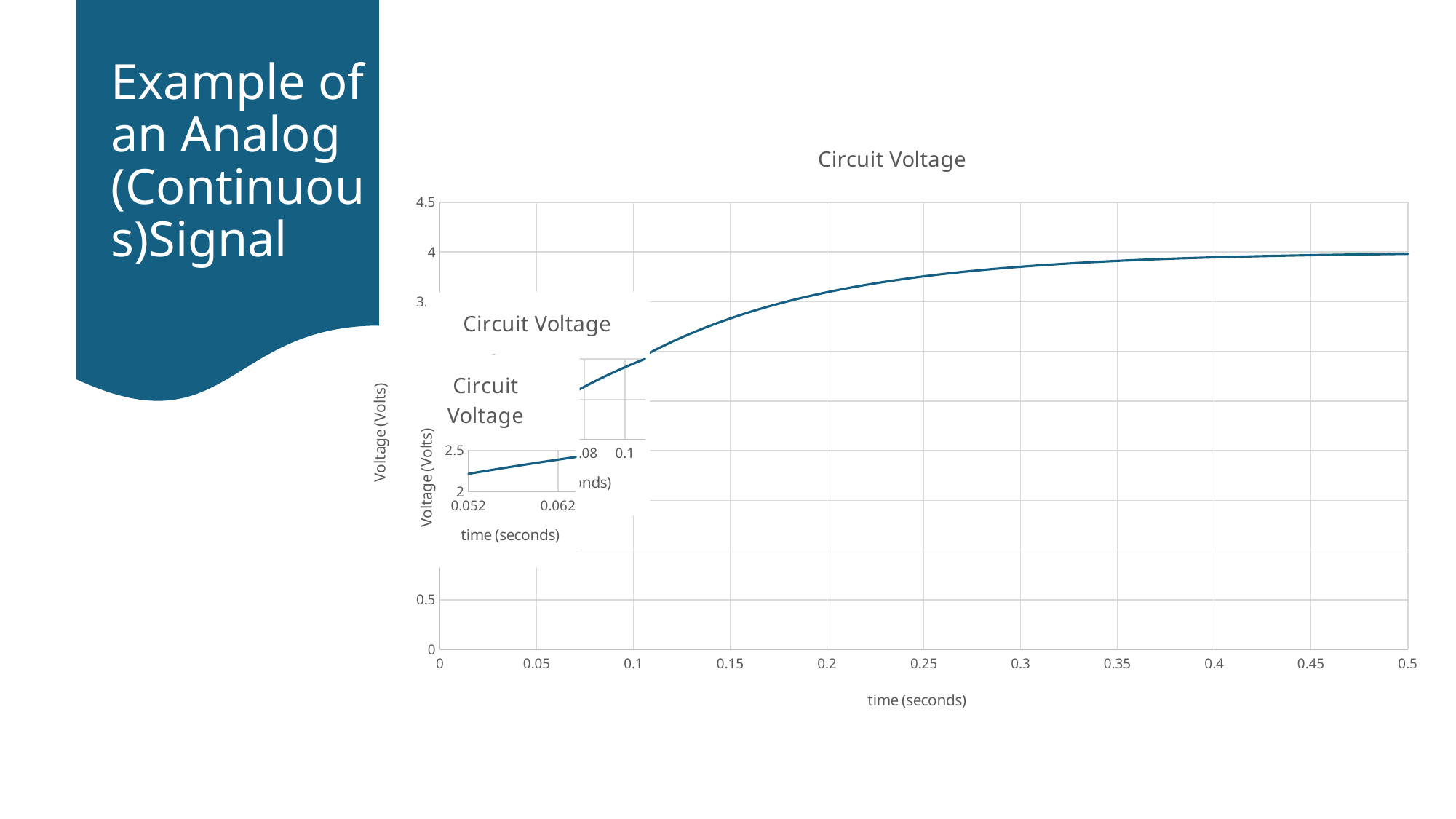
In the large Circuit Voltage chart, which is larger: the voltage at 0.1 seconds or the voltage at 0.4 seconds? 0.4 seconds In the large Circuit Voltage chart, is the voltage at 0.4 seconds greater or less than 3.5? greater In the smallest inset Circuit Voltage chart (x axis from 0.052 to 0.062), is the voltage at 0.052 seconds greater or less than 2? greater In the smallest inset Circuit Voltage chart (x axis from 0.052 to 0.062), does the voltage rise or fall as time increases? rise In the large Circuit Voltage chart, is the voltage at 0.3 seconds greater or less than 3.5? greater In the large Circuit Voltage chart, does the voltage rise or fall as time increases? rise What is the title of the large chart on the slide? Circuit Voltage In the large Circuit Voltage chart, what is the highest value shown on the y axis? 4.5 What kind of chart is the large Circuit Voltage chart? line chart What is the label of the x axis on the large Circuit Voltage chart? time (seconds)